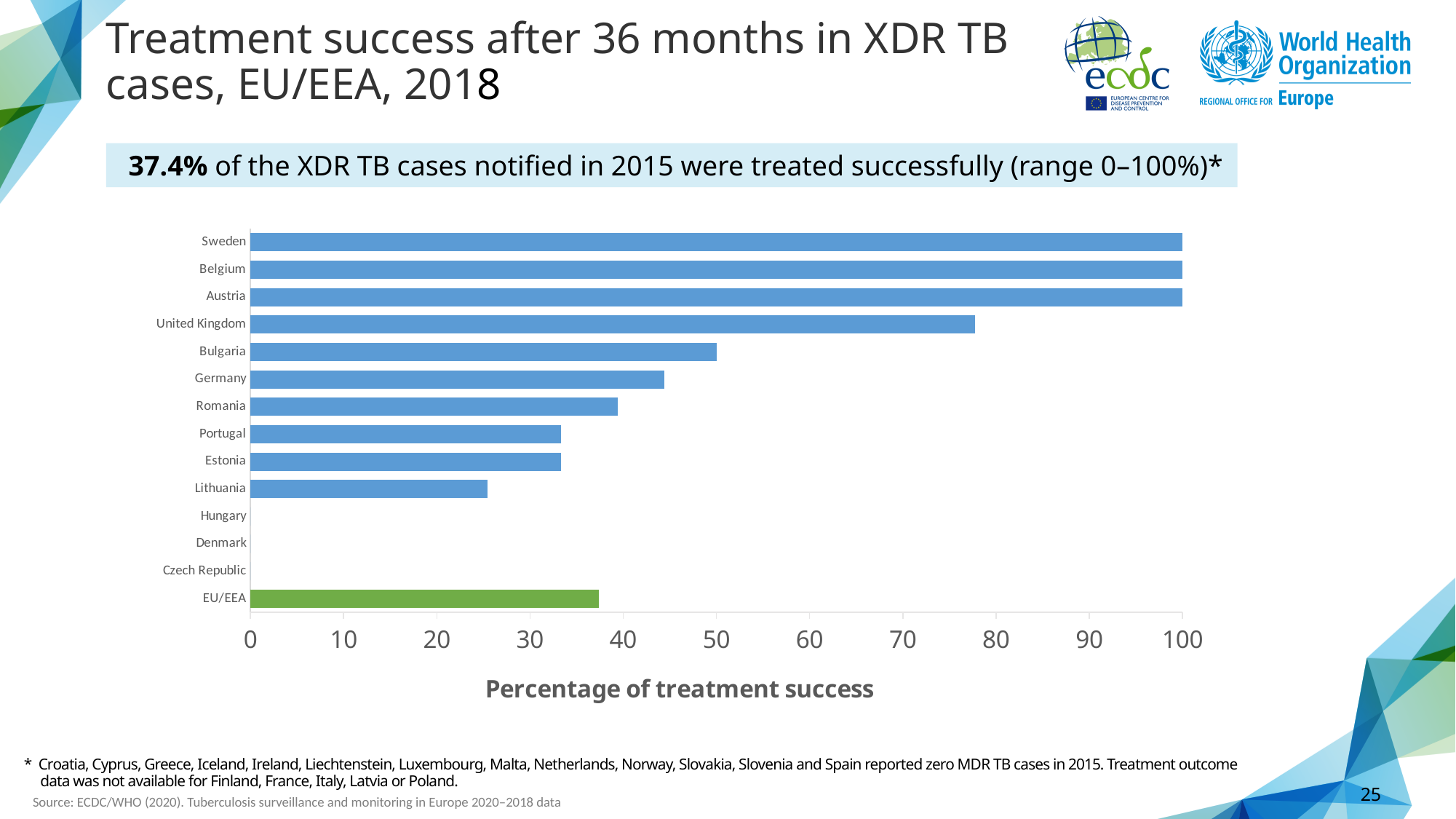
How many categories (countries plus EU/EEA) are plotted on the chart? 14 Is the value for United Kingdom greater or less than 70? greater Which has the higher percentage of treatment success, United Kingdom or Bulgaria? United Kingdom What kind of chart is shown on the slide? bar chart Is the value for Germany greater or less than 40? greater What is the percentage of treatment success for Sweden? 100 Which has the higher percentage of treatment success, Germany or Romania? Germany Is the value for Lithuania greater or less than 30? less What is the title of the x axis? Percentage of treatment success Which category's bar is coloured green rather than blue? EU/EEA What is the percentage of treatment success for EU/EEA? 37.4% What is the percentage of treatment success for Hungary? 0